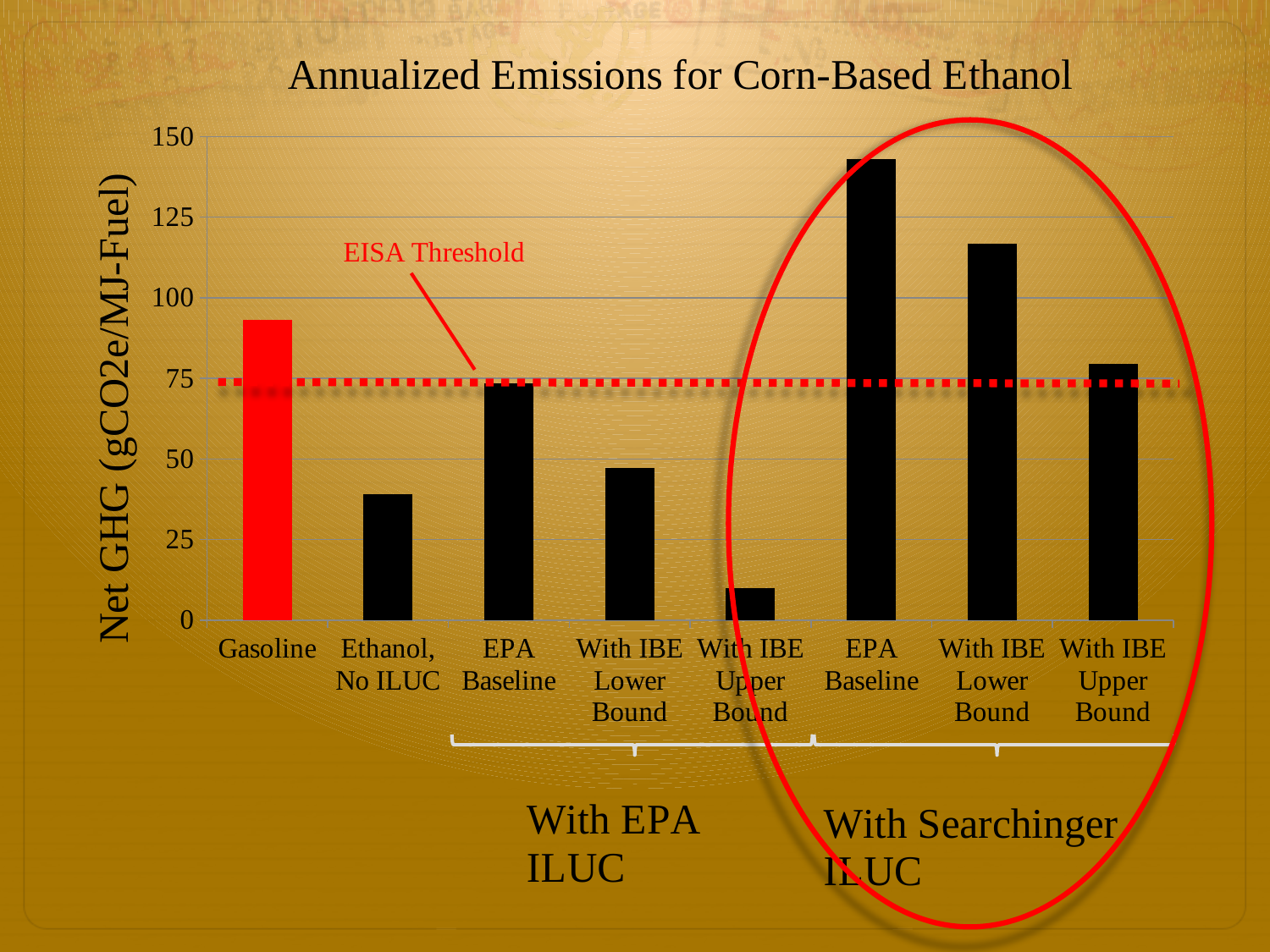
What is the title of the chart? Annualized Emissions for Corn-Based Ethanol Which bar has the highest value in the chart? EPA Baseline (With Searchinger ILUC) Is the value for With IBE Upper Bound under With EPA ILUC greater or less than 25? less What is the label on the vertical axis of the chart? Net GHG (gCO2e/MJ-Fuel) Is the value for Ethanol, No ILUC greater or less than 50? less How many bars are plotted in the chart? 8 Is the value for EPA Baseline under With Searchinger ILUC greater or less than 125? greater Which bar has the lowest value in the chart? With IBE Upper Bound (With EPA ILUC) What kind of chart is shown on the slide? bar chart Which is larger, the value for Gasoline or the value for Ethanol, No ILUC? Gasoline